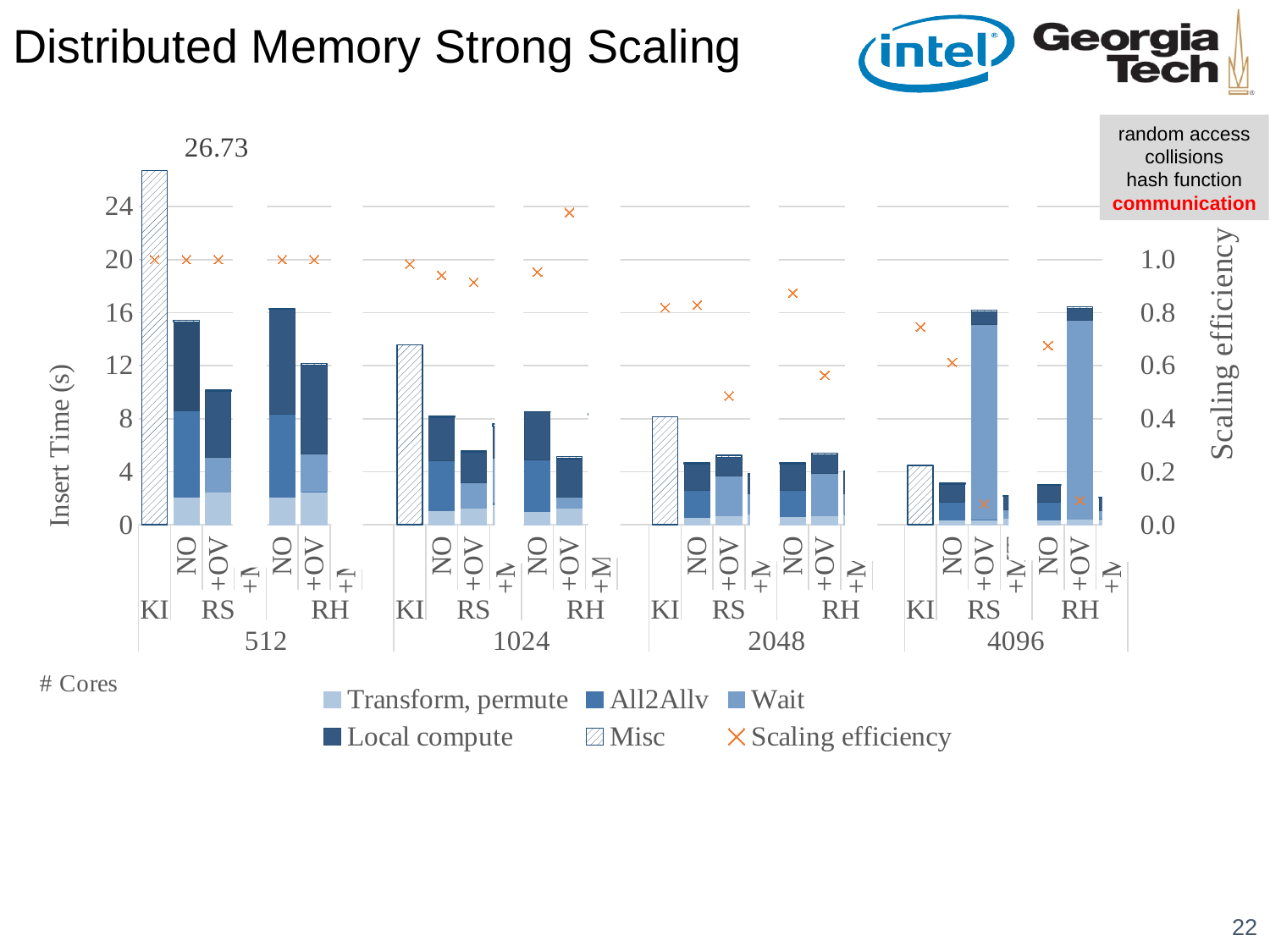
How many series does the legend list? 6 What is the title of the left vertical axis? Insert Time (s) What kind of chart is shown on the slide? Stacked bar chart with a scaling efficiency scatter overlay Is the KI bar at 1024 cores greater or less than 12 seconds? greater At which core count is the KI bar the tallest? 512 At 512 cores, which RS bar is taller: NO or +OV? NO What is the title of the right vertical axis? Scaling efficiency What is the labelled insert time for the KI bar at 512 cores? 26.73 Is the KI bar at 4096 cores greater or less than 8 seconds? less How many core counts are shown along the x axis? 4 Is the RS NO bar at 512 cores greater or less than 12 seconds? greater Does the KI insert time rise or fall as the number of cores increases from 512 to 4096? fall